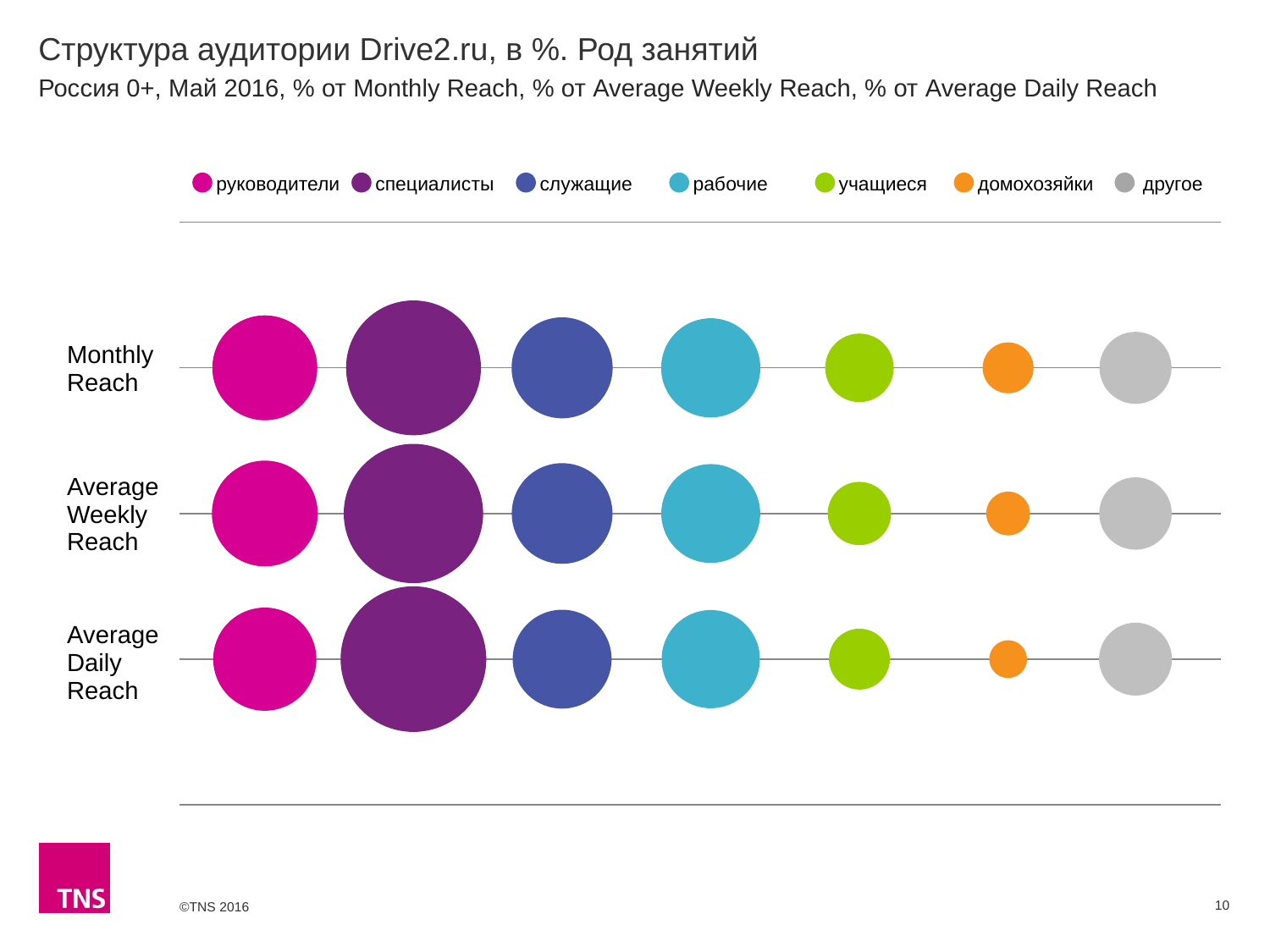
In the Average Weekly Reach row, which bubble is larger: руководители or домохозяйки? руководители Which occupation group has the largest bubble in the Monthly Reach row? специалисты How many occupation groups does the legend list? 7 What kind of chart is shown on the slide? bubble chart Which occupation group has the smallest bubble in the Average Daily Reach row? домохозяйки In the Average Daily Reach row, which bubble is larger: рабочие or домохозяйки? рабочие In the Monthly Reach row, which bubble is larger: специалисты or учащиеся? специалисты Which occupation group has the largest bubble in the Average Daily Reach row? специалисты What is the title of the chart on the slide? Структура аудитории Drive2.ru, в %. Род занятий Which occupation group has the smallest bubble in the Monthly Reach row? домохозяйки How many reach rows (categories) are plotted on the chart? 3 Which colour represents the group 'рабочие' in the legend? light blue